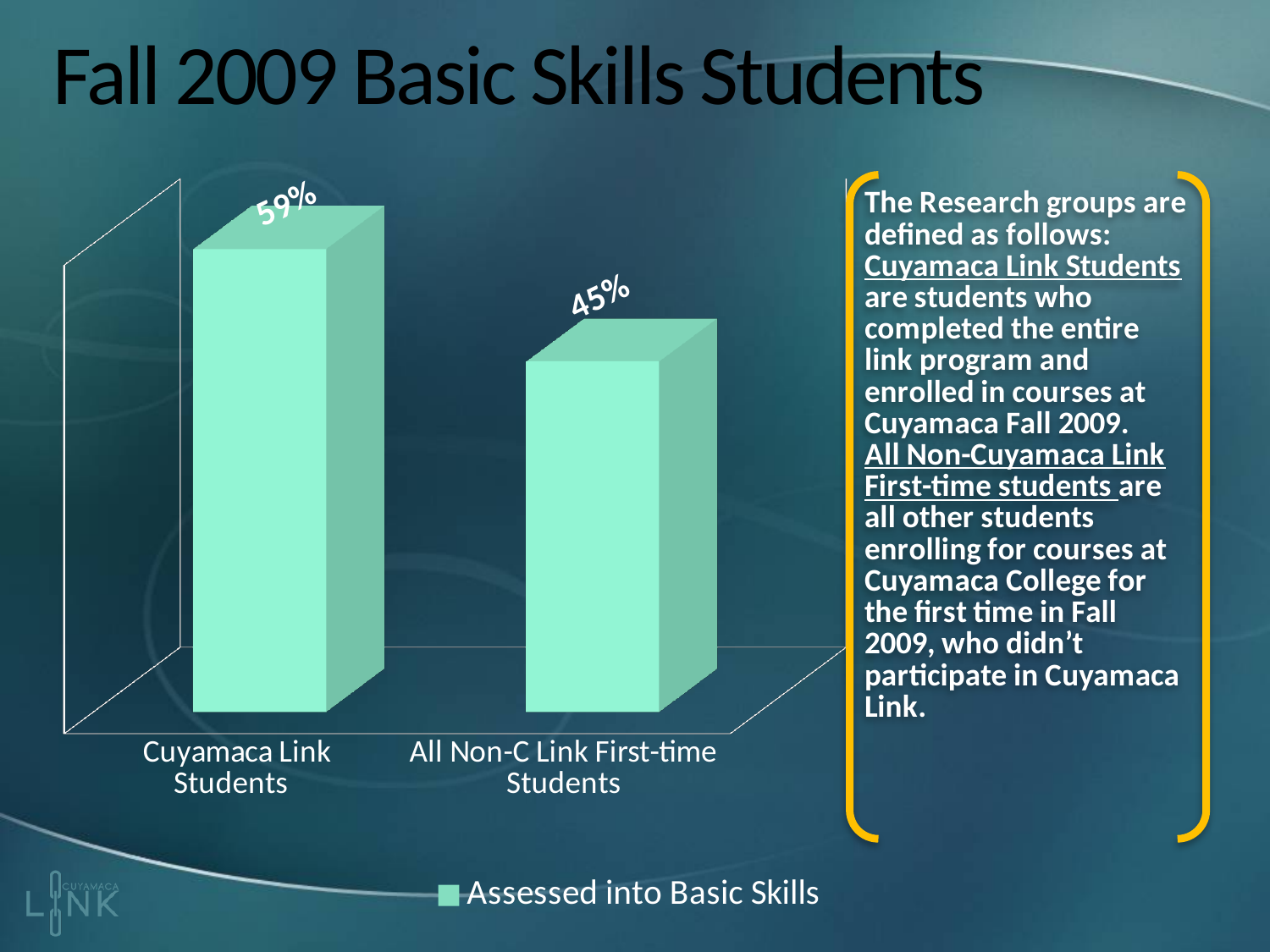
What percentage of All Non-C Link First-time Students were assessed into Basic Skills? 45% How many categories are shown on the chart? 2 Which group has the higher percentage assessed into Basic Skills? Cuyamaca Link Students Which group has the lower percentage assessed into Basic Skills? All Non-C Link First-time Students How many series does the legend list? 1 What percentage of Cuyamaca Link Students were assessed into Basic Skills? 59% What is the title of the slide containing the chart? Fall 2009 Basic Skills Students What kind of chart is shown on the slide? bar chart What is the difference in percentage points between Cuyamaca Link Students and All Non-C Link First-time Students assessed into Basic Skills? 14 percentage points Is the value for Cuyamaca Link Students larger or smaller than the value for All Non-C Link First-time Students? larger What is the name of the series listed in the chart legend? Assessed into Basic Skills